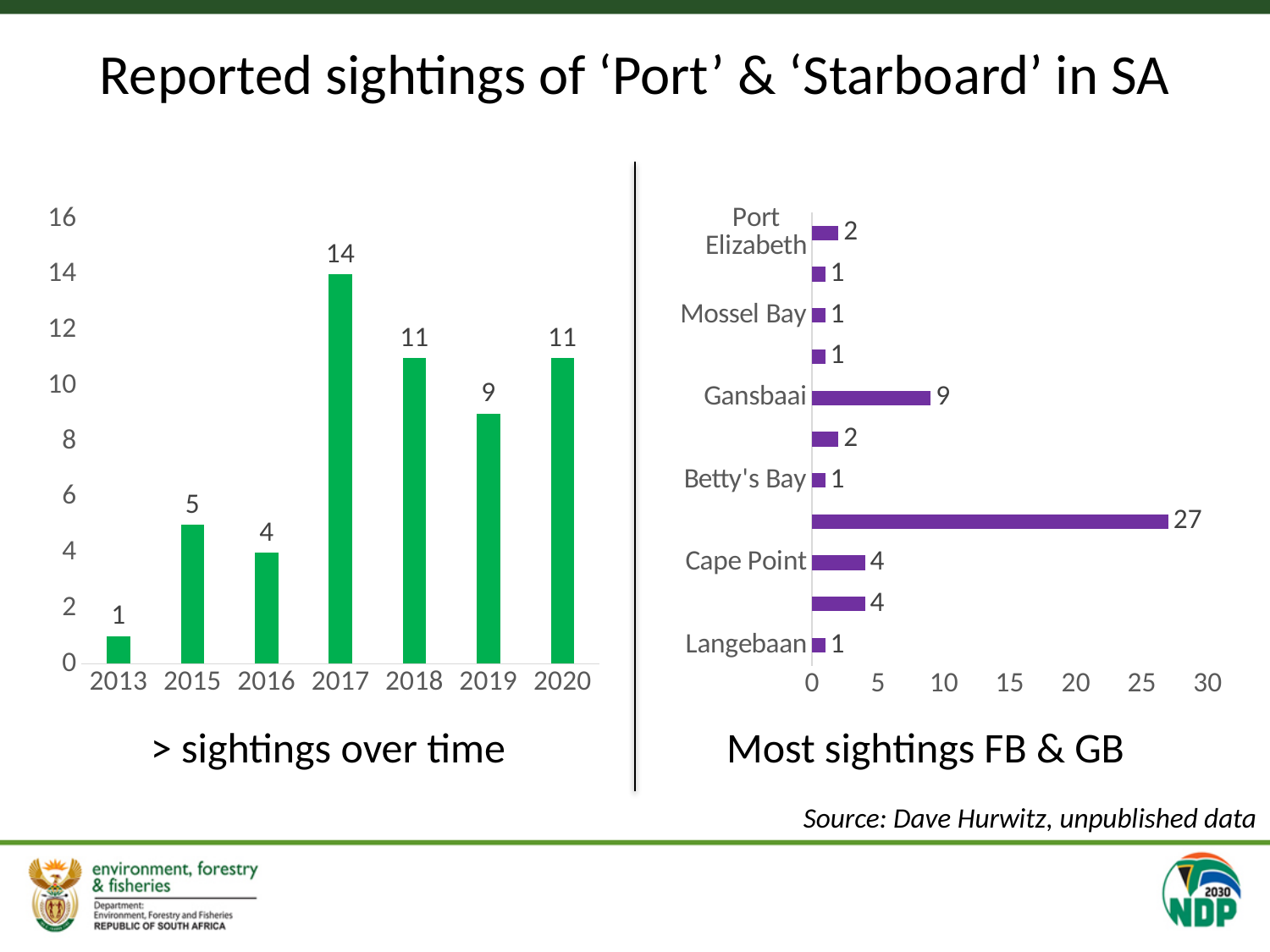
On the right chart (Most sightings FB & GB), how many sightings are shown for Gansbaai? 9 On the left chart (sightings over time), how many sightings were reported in 2013? 1 On the left chart (sightings over time), how many years are shown on the x axis? 7 On the left chart (sightings over time), which year had more sightings, 2015 or 2016? 2015 On the left chart (sightings over time), which year has the lowest number of sightings? 2013 On the right chart (Most sightings FB & GB), what is the difference between the sightings for Gansbaai and Cape Point? 5 On the right chart (Most sightings FB & GB), how many sightings are shown for Cape Point? 4 On the right chart (Most sightings FB & GB), which location has more sightings, Gansbaai or Port Elizabeth? Gansbaai On the left chart (sightings over time), how many sightings were reported in 2017? 14 On the left chart (sightings over time), what is the difference between the sightings in 2017 and 2019? 5 What kind of chart is the left chart (sightings over time)? Bar chart On the left chart (sightings over time), which year has the highest number of sightings? 2017